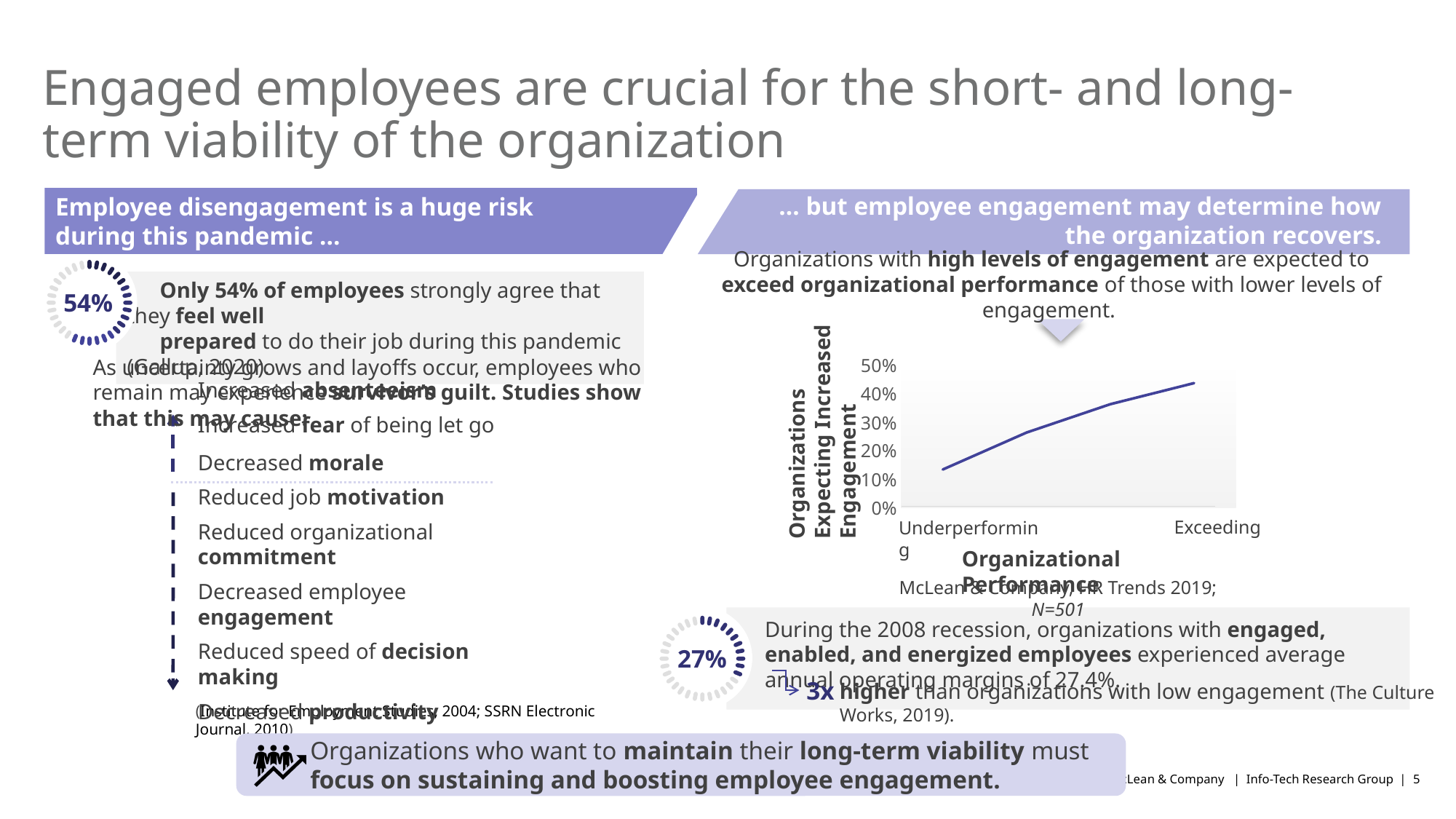
What is the title of the y axis of the line chart? Organizations Expecting Increased Engagement In the line chart, which has the larger value: Underperforming or Exceeding? Exceeding In the line chart, is the value for Underperforming greater or less than 20%? less What is the highest tick value shown on the y axis of the line chart? 50% In the line chart, which labelled category on the x axis has the lowest value? Underperforming In the line chart, do the values rise or fall as organizational performance moves from Underperforming to Exceeding? rise How many category labels are shown on the x axis of the line chart? 2 What kind of chart is shown on the right side of the slide? line chart In the line chart, is the value for Underperforming greater or less than 10%? greater In the line chart, which labelled category on the x axis has the highest value? Exceeding In the line chart, is the value for Exceeding greater or less than 40%? greater